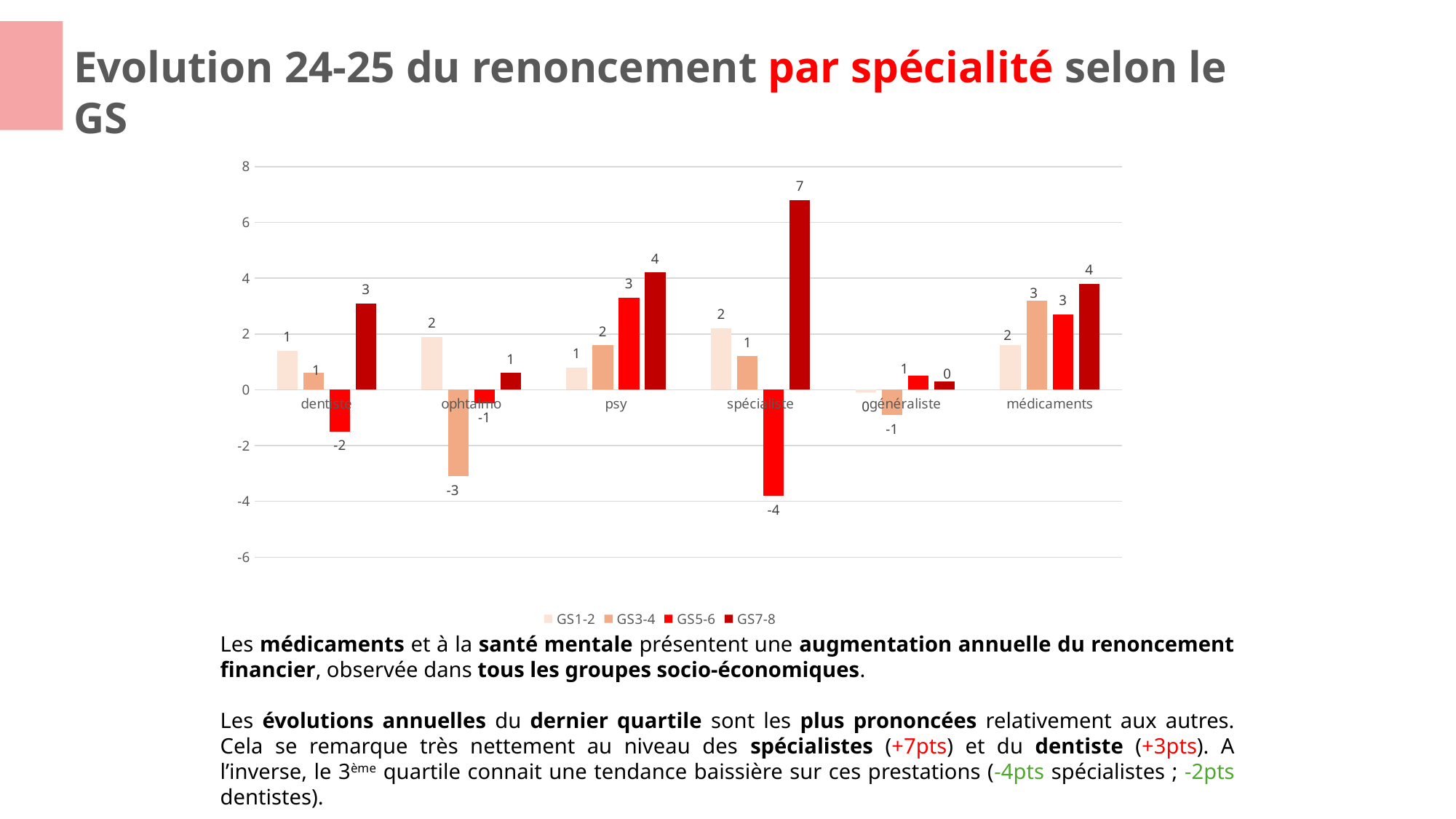
What is the value for GS7-8 in the spécialiste category? 7 What kind of chart is shown on the slide? bar chart In the psy category, do the values rise or fall from GS1-2 to GS7-8? rise For the GS7-8 series, which is larger: dentiste or ophtalmo? dentiste How many series does the legend list? 4 Is the value for GS7-8 in the spécialiste category greater or less than 6? greater Which series has the highest value in the psy category? GS7-8 Which category has the lowest value for the GS5-6 series? spécialiste What are the four legend entries of the chart? GS1-2, GS3-4, GS5-6, GS7-8 How many specialty categories are shown on the x axis? 6 In the spécialiste category, what is the difference between the GS7-8 value and the GS5-6 value? 11 What is the value for GS3-4 in the ophtalmo category? -3